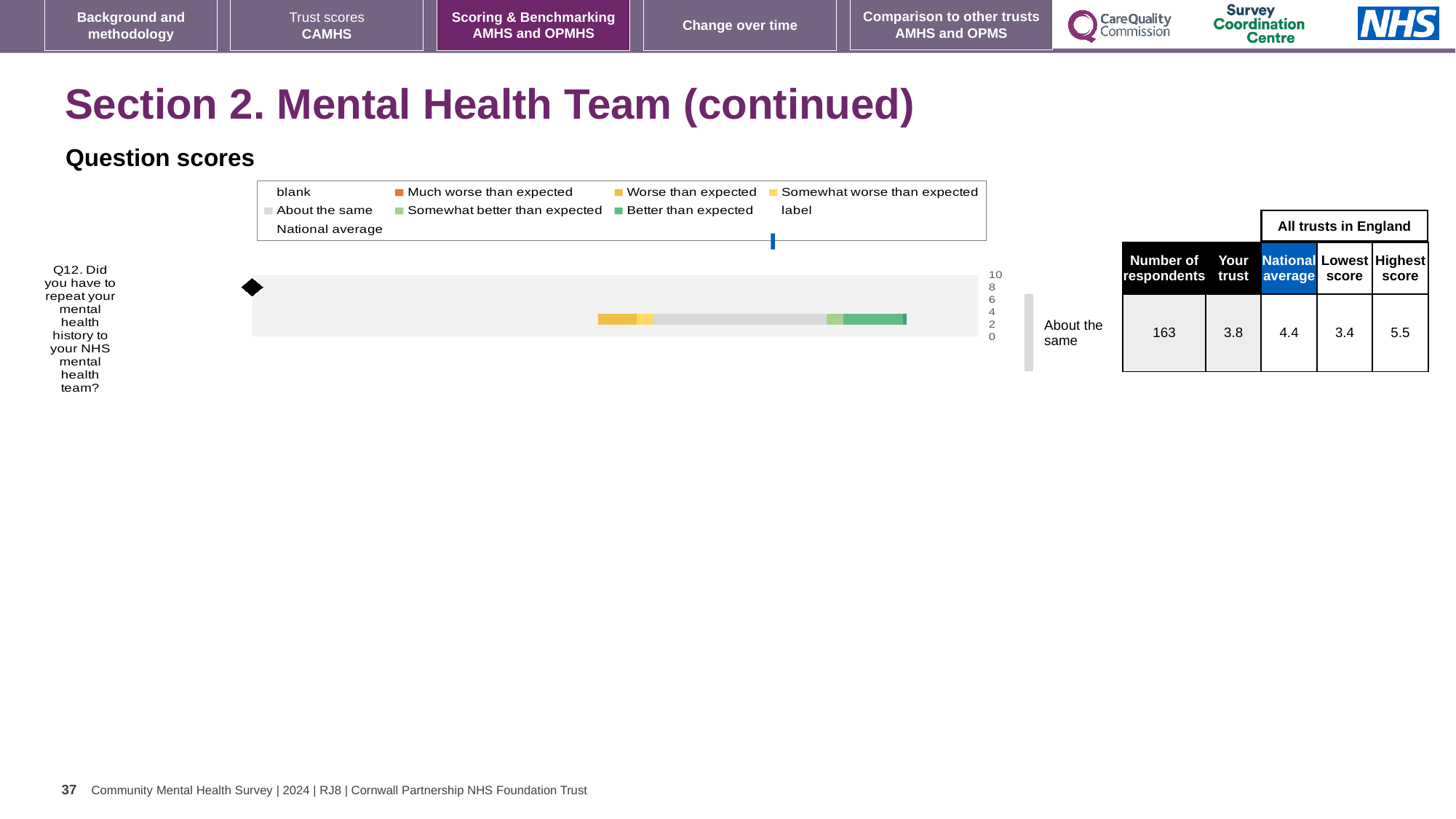
Which is larger for Q12, the 'Your trust' score or the national average? National average What kind of chart is shown for Q12 on the slide? bar chart In the table beside the chart, what is the highest score among all trusts in England for Q12? 5.5 In the table beside the chart, what is the national average for Q12? 4.4 What is the highest tick value shown on the chart's axis? 10 What benchmark category label is shown next to the Q12 bar? About the same In the table beside the chart, what is the number of respondents for Q12? 163 In the table beside the chart, what is the lowest score among all trusts in England for Q12? 3.4 How many questions (categories) are plotted in the chart? 1 In the table beside the chart, what is the 'Your trust' score for Q12? 3.8 What is the difference between the highest score and the lowest score for Q12 in the table? 2.1